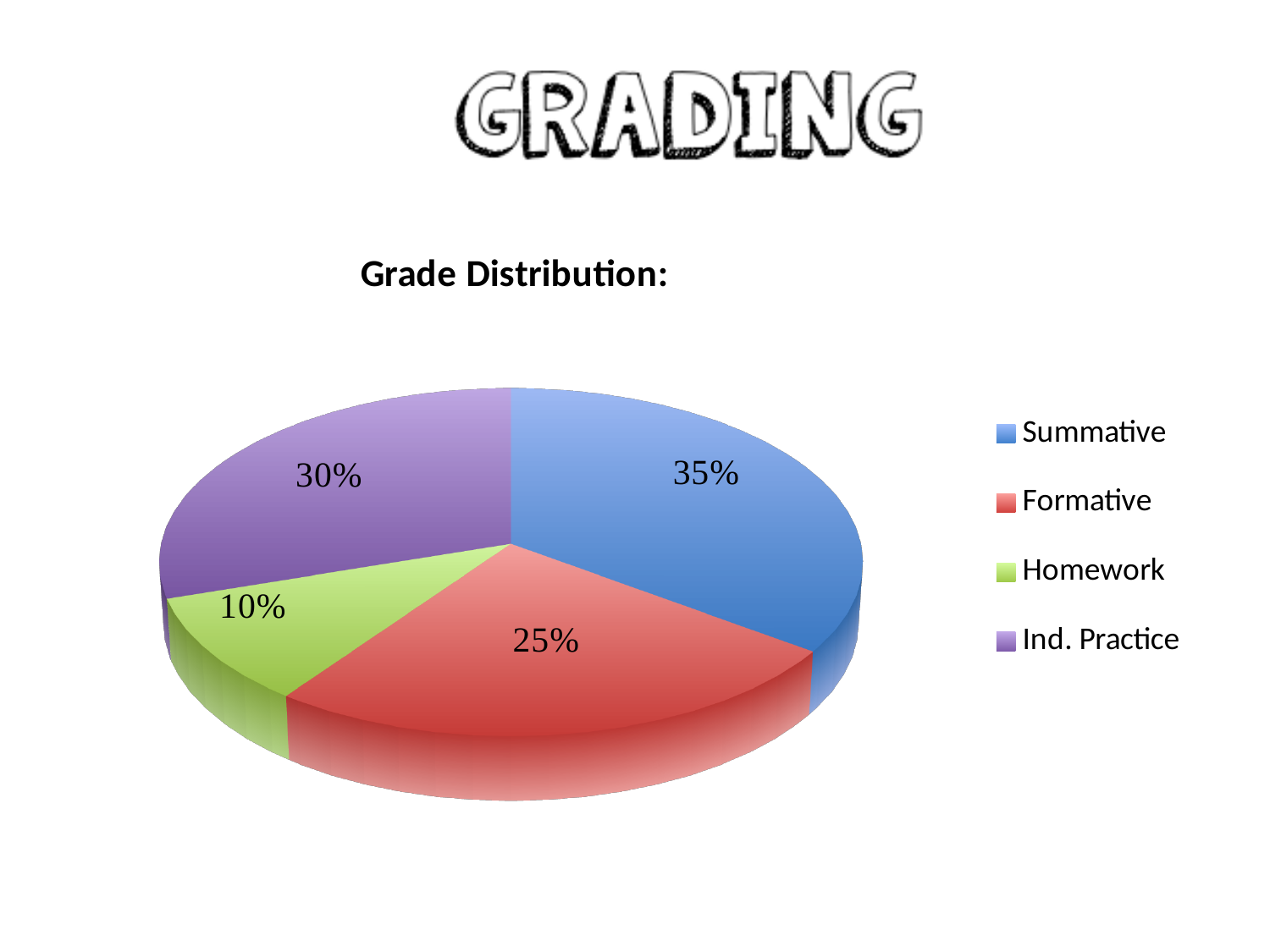
What percentage of the grade is Summative? 35% What percentage of the grade is Homework? 10% What percentage of the grade is Ind. Practice? 30% How many categories are shown in the pie chart? 4 What is the title of the chart? Grade Distribution: Which is larger, the Formative share or the Ind. Practice share? Ind. Practice Which category has the smallest share of the grade? Homework What is the difference between the Summative and Formative shares? 10% What kind of chart is shown on the slide? Pie chart What is the difference between the Ind. Practice and Homework shares? 20% What percentage of the grade is Formative? 25% Which category has the largest share of the grade? Summative